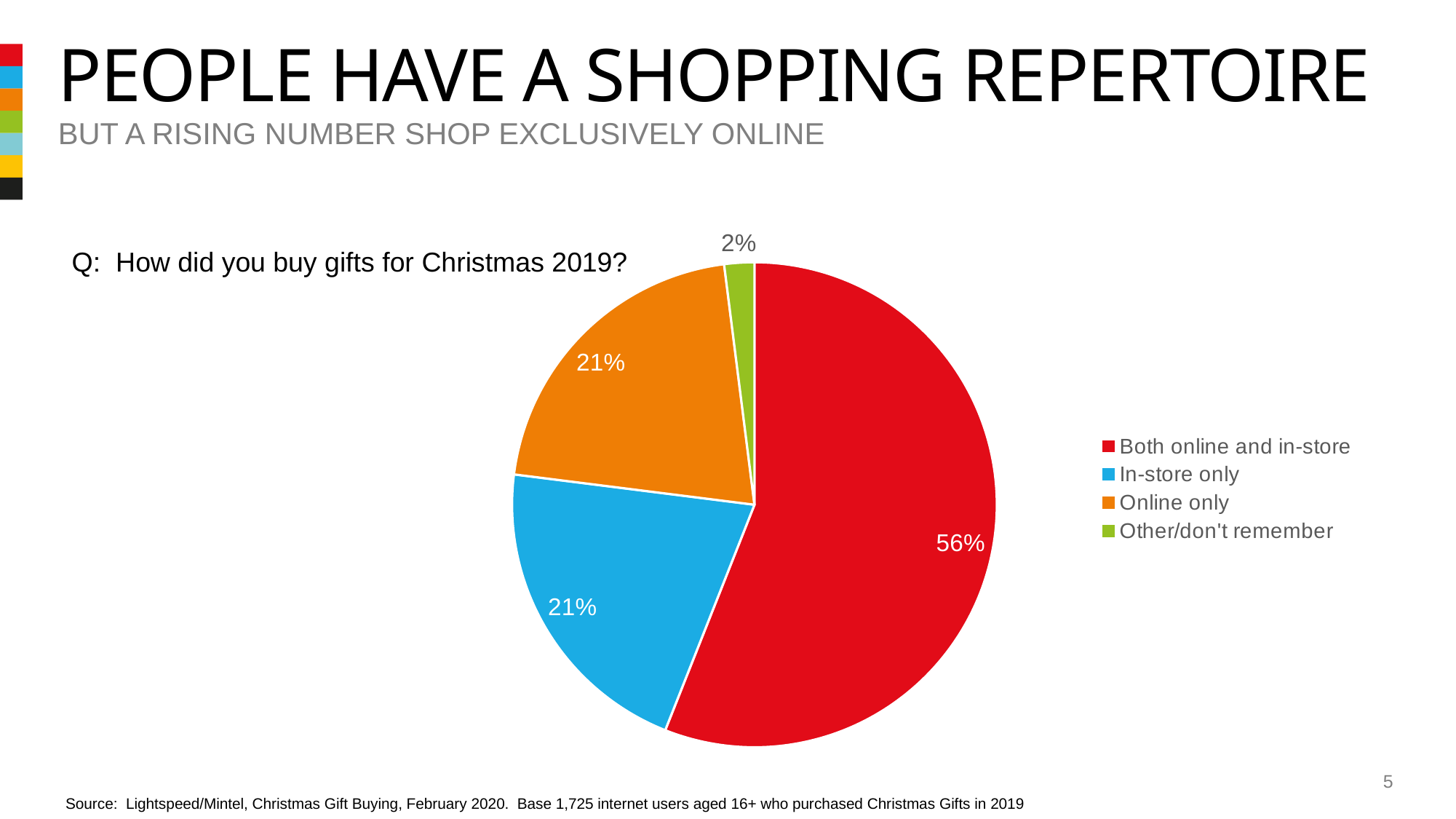
What share of respondents bought gifts online only? 21% Which category has the smallest slice of the pie? Other/don't remember What share of respondents answered Other/don't remember? 2% What kind of chart is shown on the slide? Pie chart What colour is the slice for Online only? Orange What share of respondents bought gifts in-store only? 21% How many categories does the pie chart show? 4 What share of respondents bought gifts both online and in-store? 56% Which is larger: the share for In-store only or the share for Other/don't remember? In-store only What is the difference between the share for Both online and in-store and the share for Online only? 35% What question is the pie chart based on? How did you buy gifts for Christmas 2019? Which category has the largest slice of the pie? Both online and in-store